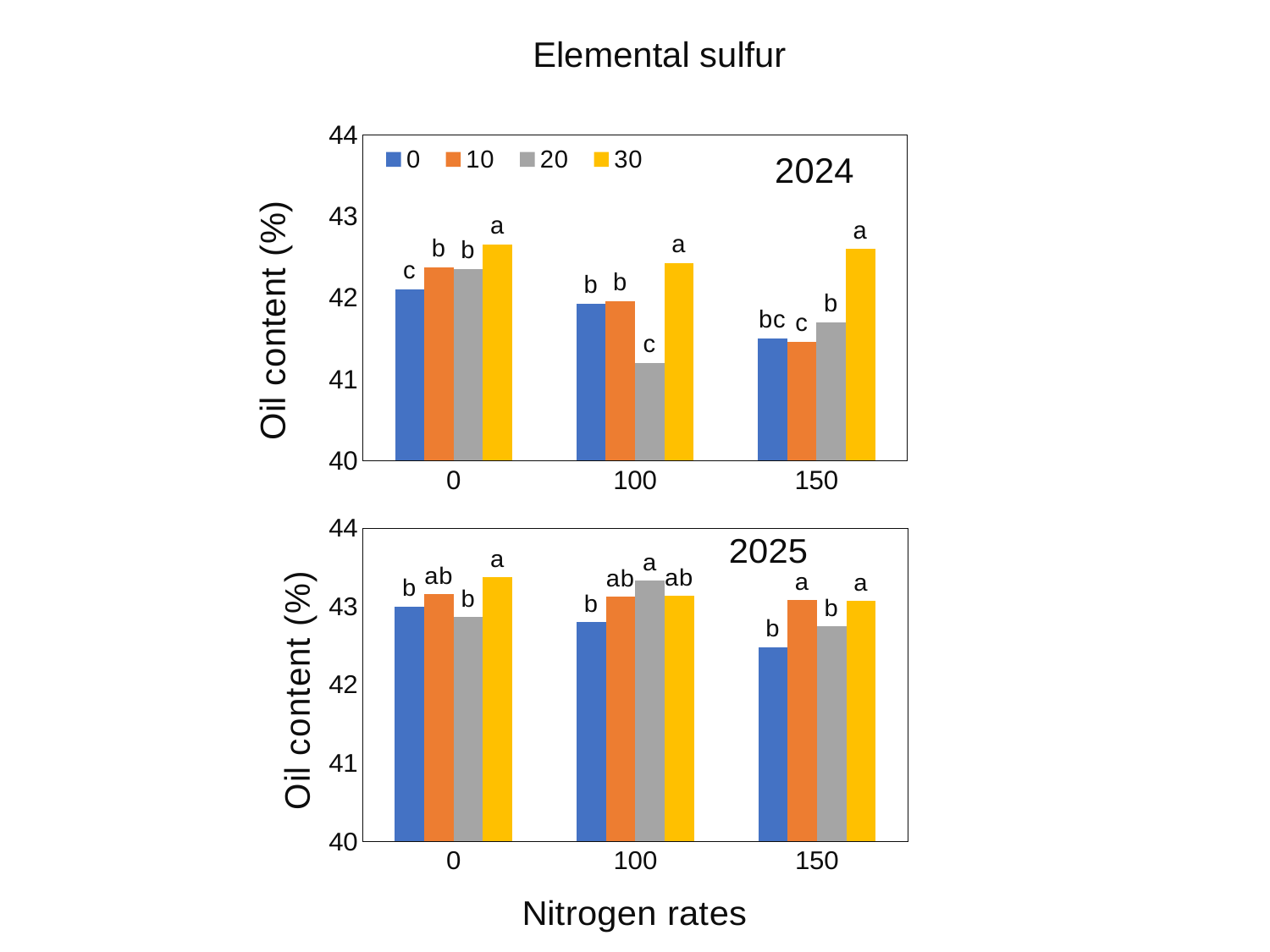
How many nitrogen rate categories are shown on the x axis of the 2025 chart? 3 How many series does the legend of the 2024 chart list? 4 In the 2024 chart, is the oil content for series 20 at nitrogen rate 100 greater or less than 42? less In the 2024 chart, which elemental sulfur series has the highest oil content at nitrogen rate 0? 30 In the 2025 chart, is the oil content for series 0 at nitrogen rate 150 greater or less than 43? less In the 2025 chart, which elemental sulfur series has the lowest oil content at nitrogen rate 150? 0 In the 2024 chart, at nitrogen rate 150, which is larger: the oil content for series 30 or for series 0? 30 In the 2025 chart, does the oil content for series 0 rise or fall as the nitrogen rate increases from 0 to 150? fall What is the y-axis title of the 2024 chart? Oil content (%) In the 2025 chart, which elemental sulfur series has the highest oil content at nitrogen rate 100? 20 In the 2024 chart, which elemental sulfur series has the lowest oil content at nitrogen rate 100? 20 What kind of chart is the 2024 chart? bar chart